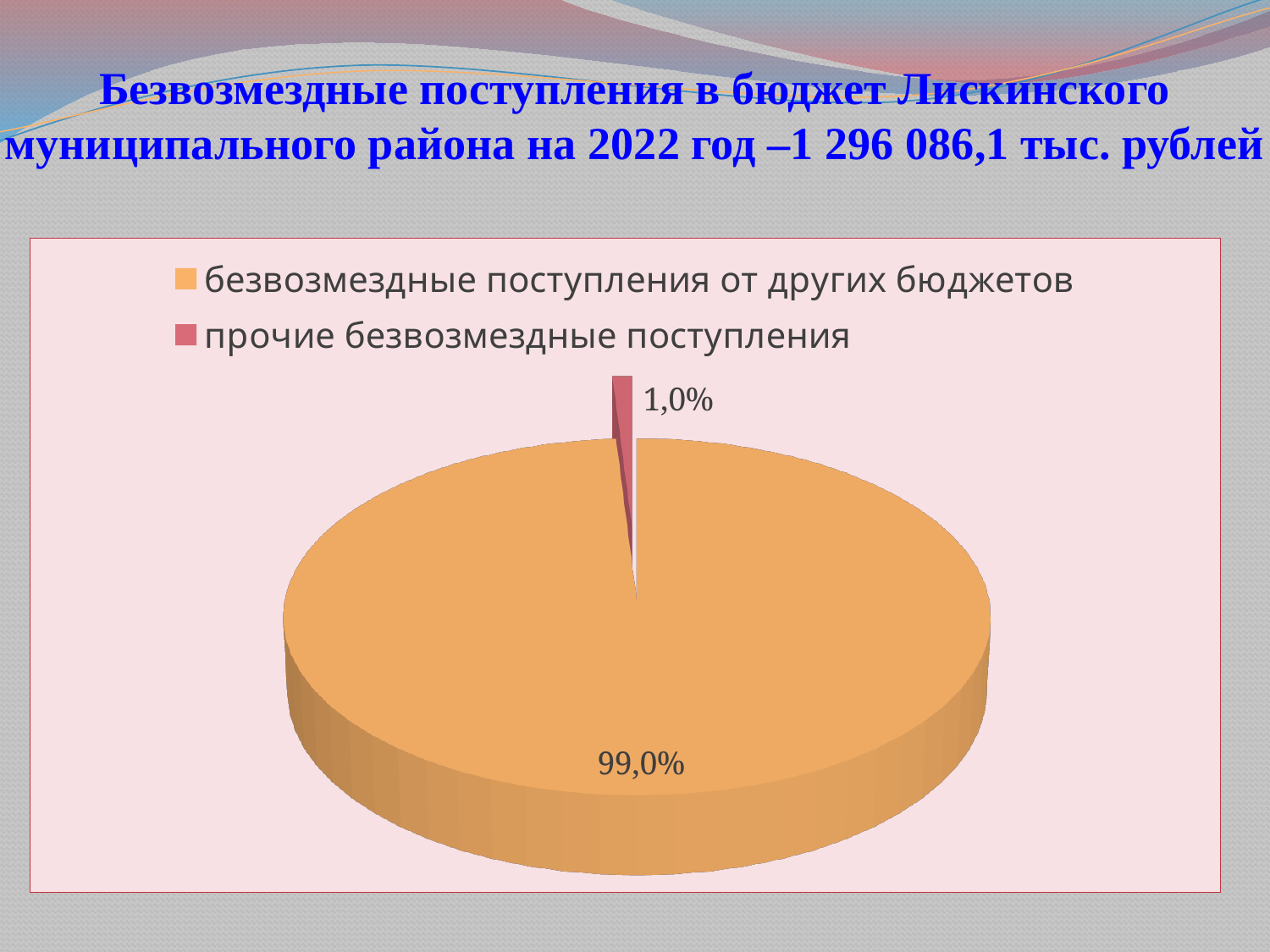
Which category has the smallest slice of the pie? прочие безвозмездные поступления What kind of chart is shown on the slide? pie chart How many entries does the legend list? 2 What colour is the slice for 'прочие безвозмездные поступления'? red How many categories are shown in the pie chart? 2 Which category has the largest slice of the pie? безвозмездные поступления от других бюджетов What is the difference in percentage points between the two slices? 98,0% What share of the pie does 'прочие безвозмездные поступления' represent? 1,0% Which is larger: the slice for 'прочие безвозмездные поступления' or the slice for 'безвозмездные поступления от других бюджетов'? безвозмездные поступления от других бюджетов What share of the pie does 'безвозмездные поступления от других бюджетов' represent? 99,0% What total amount in thousand rubles is stated in the slide title for 2022? 1 296 086,1 тыс. рублей